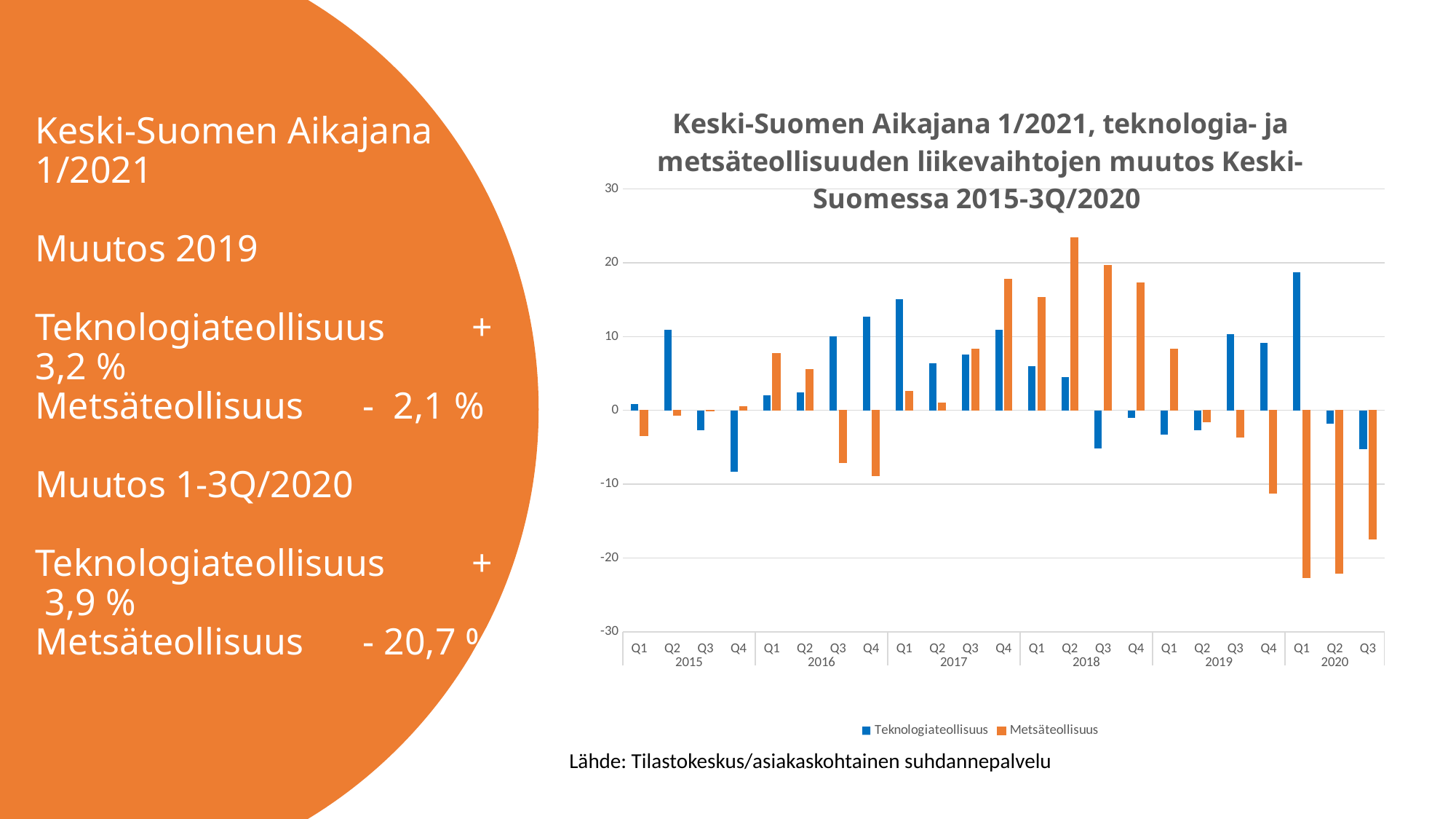
What kind of chart is shown on the slide? Bar chart Is the value for Teknologiateollisuus in Q1 2020 greater or less than 20? less In Q1 2017, which series has the larger value, Teknologiateollisuus or Metsäteollisuus? Teknologiateollisuus How many series does the chart legend list? 2 Is the value for Metsäteollisuus in Q2 2018 greater or less than 20? greater How many quarters are plotted on the x axis of the chart? 23 In which quarter does Teknologiateollisuus reach its highest value? Q1 2020 Is the value for Metsäteollisuus in Q4 2019 greater or less than -10? less Do the Metsäteollisuus values rise or fall from Q2 2018 to Q1 2020? Fall Which colour represents Metsäteollisuus in the chart? Orange In which quarter does Metsäteollisuus reach its highest value? Q2 2018 In which quarter does Teknologiateollisuus reach its lowest value? Q4 2015